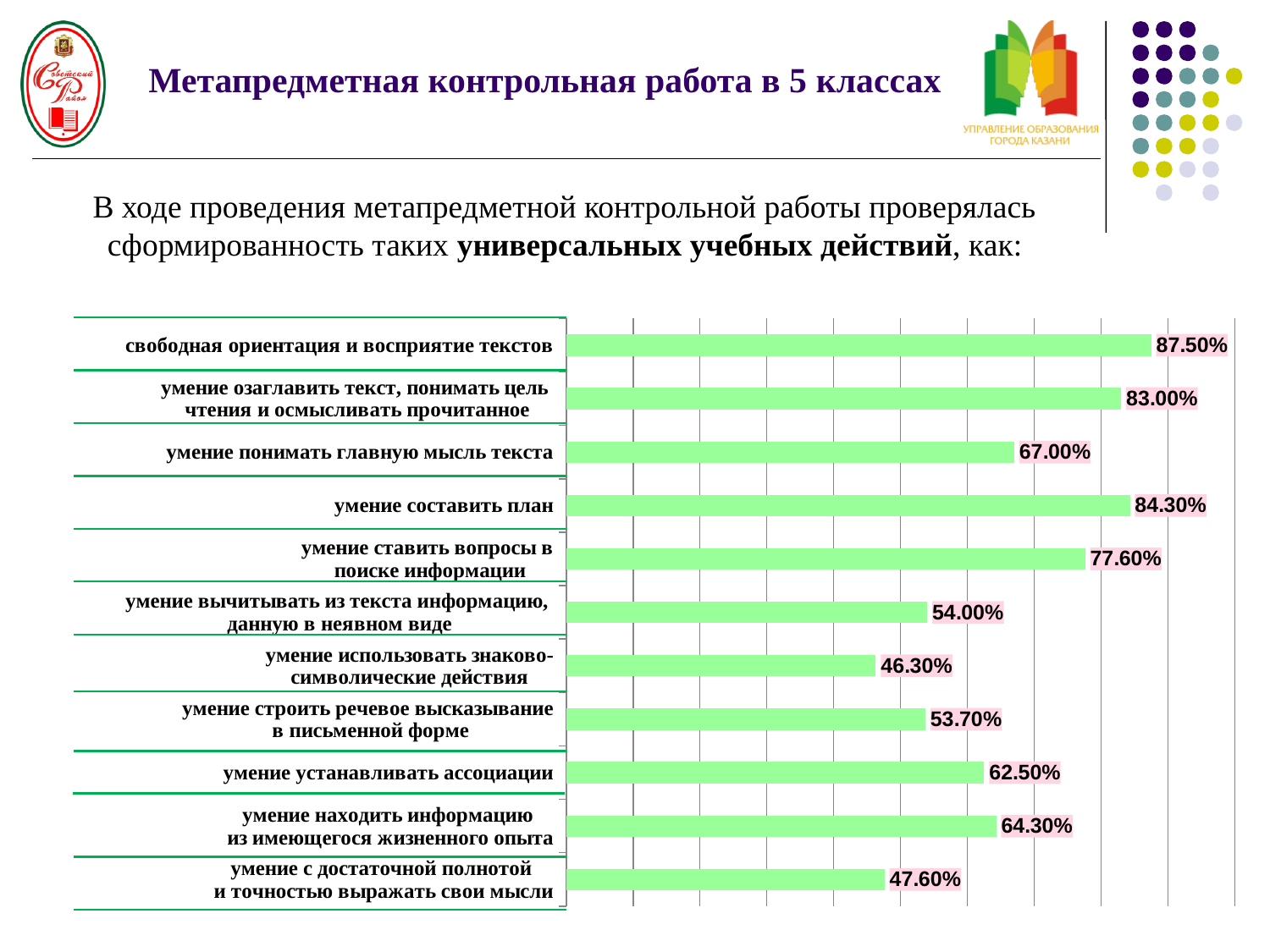
What is the value for «умение составить план»? 84.30% Which is larger: «умение находить информацию из имеющегося жизненного опыта» or «умение с достаточной полнотой и точностью выражать свои мысли»? умение находить информацию из имеющегося жизненного опыта Which category has the highest value? свободная ориентация и восприятие текстов What is the difference between the highest value (87.50%) and the lowest value (46.30%)? 41.20% What is the difference between «умение составить план» and «умение понимать главную мысль текста»? 17.30% What is the value for «умение использовать знаково-символические действия»? 46.30% What kind of chart is shown on the slide? bar chart How many categories are shown in the chart? 11 What is the value for «свободная ориентация и восприятие текстов»? 87.50% What is the value for «умение ставить вопросы в поиске информации»? 77.60% Which category has the lowest value? умение использовать знаково-символические действия What is the value for «умение устанавливать ассоциации»? 62.50%